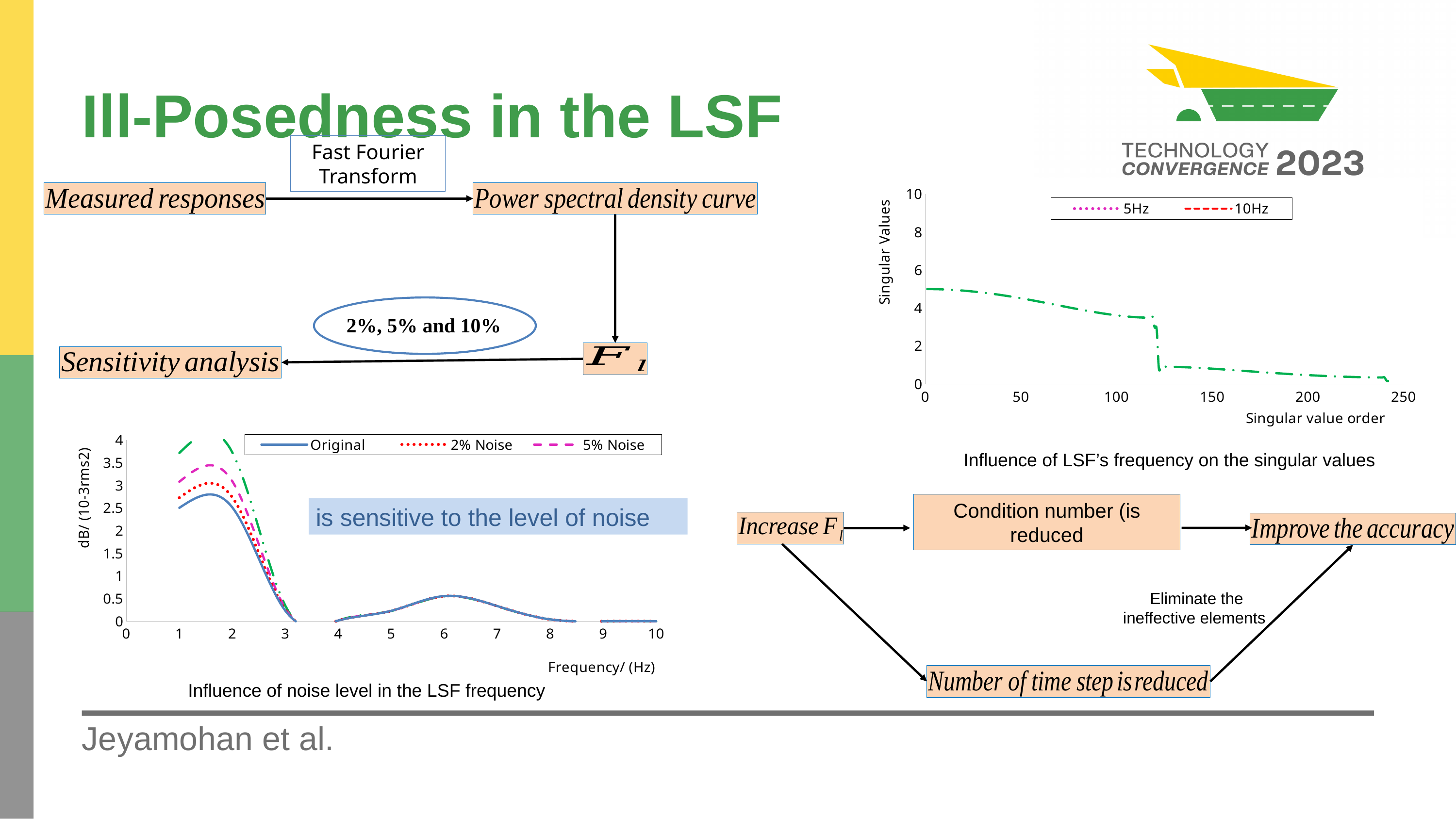
In the bottom-left chart 'Influence of noise level in the LSF frequency', is the value of the Original series at 6 Hz greater or less than 1? less What kind of chart is the bottom-left chart titled 'Influence of noise level in the LSF frequency'? line chart How many series does the legend of the top-right chart 'Influence of LSF's frequency on the singular values' list? 2 In the bottom-left chart 'Influence of noise level in the LSF frequency', what are the three series named in the legend? Original, 2% Noise, 5% Noise What kind of chart is the top-right chart titled 'Influence of LSF's frequency on the singular values'? line chart In the bottom-left chart 'Influence of noise level in the LSF frequency', do the curves rise or fall between 2 Hz and 3 Hz? fall How many series does the legend of the bottom-left chart 'Influence of noise level in the LSF frequency' list? 3 What is the x-axis label of the bottom-left chart 'Influence of noise level in the LSF frequency'? Frequency/ (Hz) In the top-right chart 'Influence of LSF's frequency on the singular values', do the singular values rise or fall as the singular value order increases? fall In the top-right chart 'Influence of LSF's frequency on the singular values', is the singular value at order 0 greater or less than 6? less In the bottom-left chart 'Influence of noise level in the LSF frequency', is the peak value of the Original series near 1.5 Hz greater or less than 2.5? greater